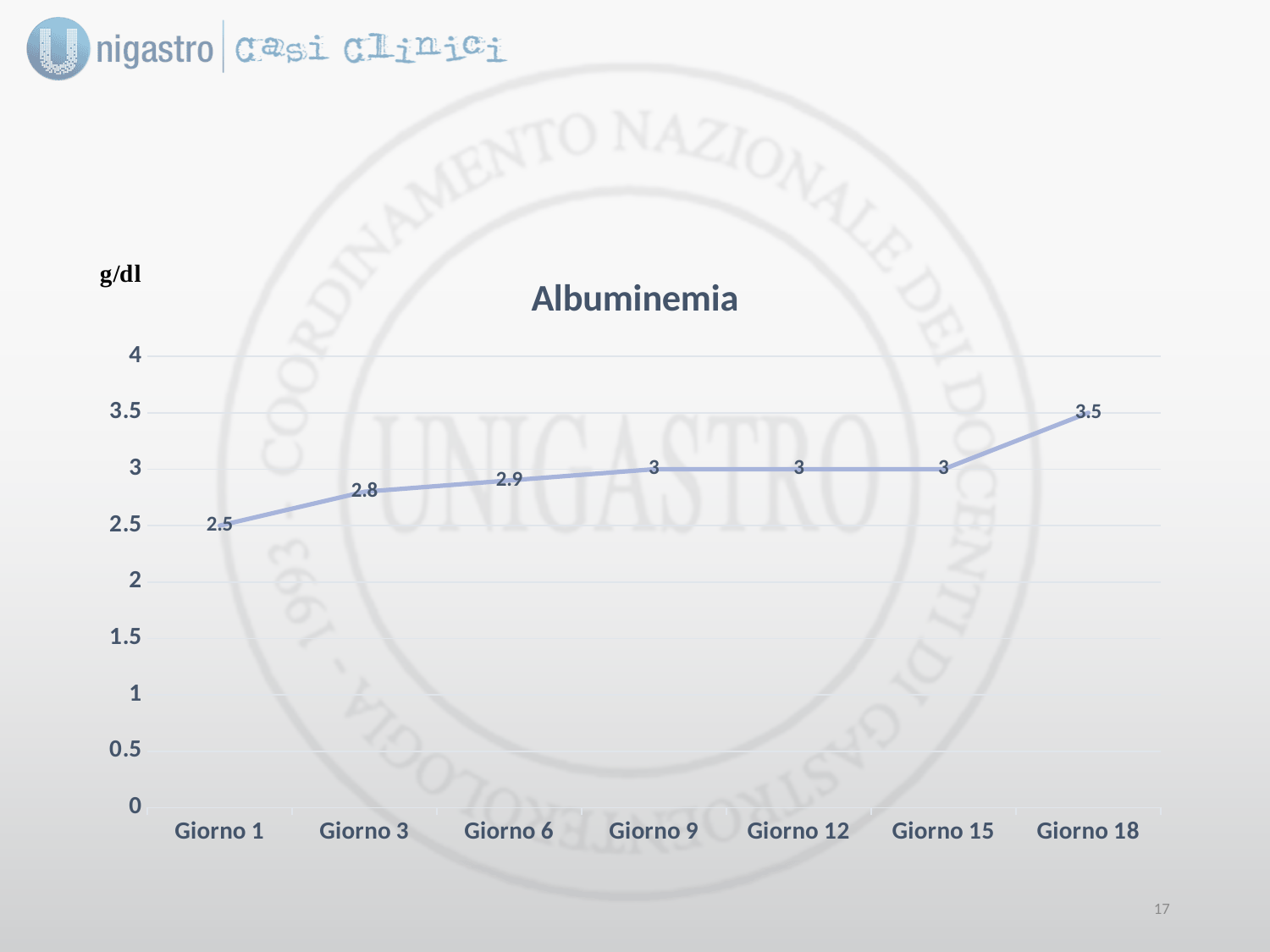
What is the title of the chart? Albuminemia What is the albuminemia value on Giorno 6? 2.9 What is the difference between the albuminemia values on Giorno 18 and Giorno 1? 1 Which is larger, the albuminemia value on Giorno 3 or on Giorno 9? Giorno 9 What is the albuminemia value on Giorno 18? 3.5 On which day is the albuminemia value lowest? Giorno 1 What is the albuminemia value on Giorno 12? 3 How many days (data points) are plotted on the chart? 7 What is the albuminemia value on Giorno 1? 2.5 What kind of chart is shown on the slide? Line chart Do the albuminemia values rise or fall from Giorno 1 to Giorno 18? Rise On which day is the albuminemia value highest? Giorno 18